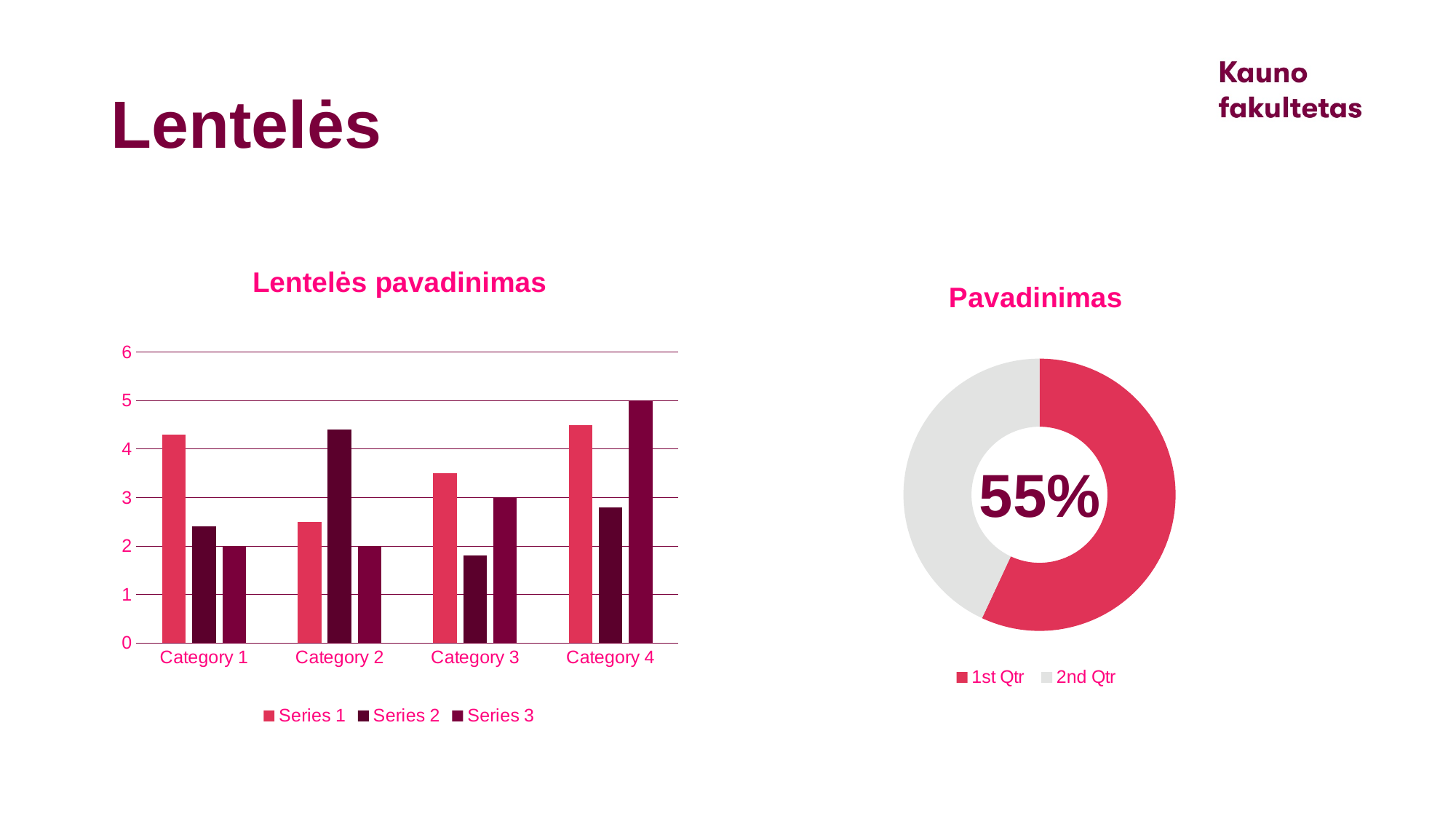
In the chart titled "Lentelės pavadinimas", which is larger for Category 2: Series 1 or Series 2? Series 2 In the chart titled "Lentelės pavadinimas", which category has the lowest value for Series 2? Category 3 In the chart titled "Lentelės pavadinimas", what is the value of Series 3 for Category 4? 5 What kind of chart is the chart titled "Lentelės pavadinimas"? bar chart In the chart titled "Lentelės pavadinimas", what is the value of Series 3 for Category 3? 3 In the chart titled "Lentelės pavadinimas", how many series does the legend list? 3 What kind of chart is the chart titled "Pavadinimas"? doughnut chart In the chart titled "Lentelės pavadinimas", is the value of Series 1 for Category 1 greater or less than 4? greater In the chart titled "Lentelės pavadinimas", which category has the highest value for Series 3? Category 4 In the chart titled "Pavadinimas", how many entries does the legend list? 2 In the chart titled "Lentelės pavadinimas", how many categories are shown on the x axis? 4 In the chart titled "Pavadinimas", what percentage is printed in the centre of the doughnut? 55%